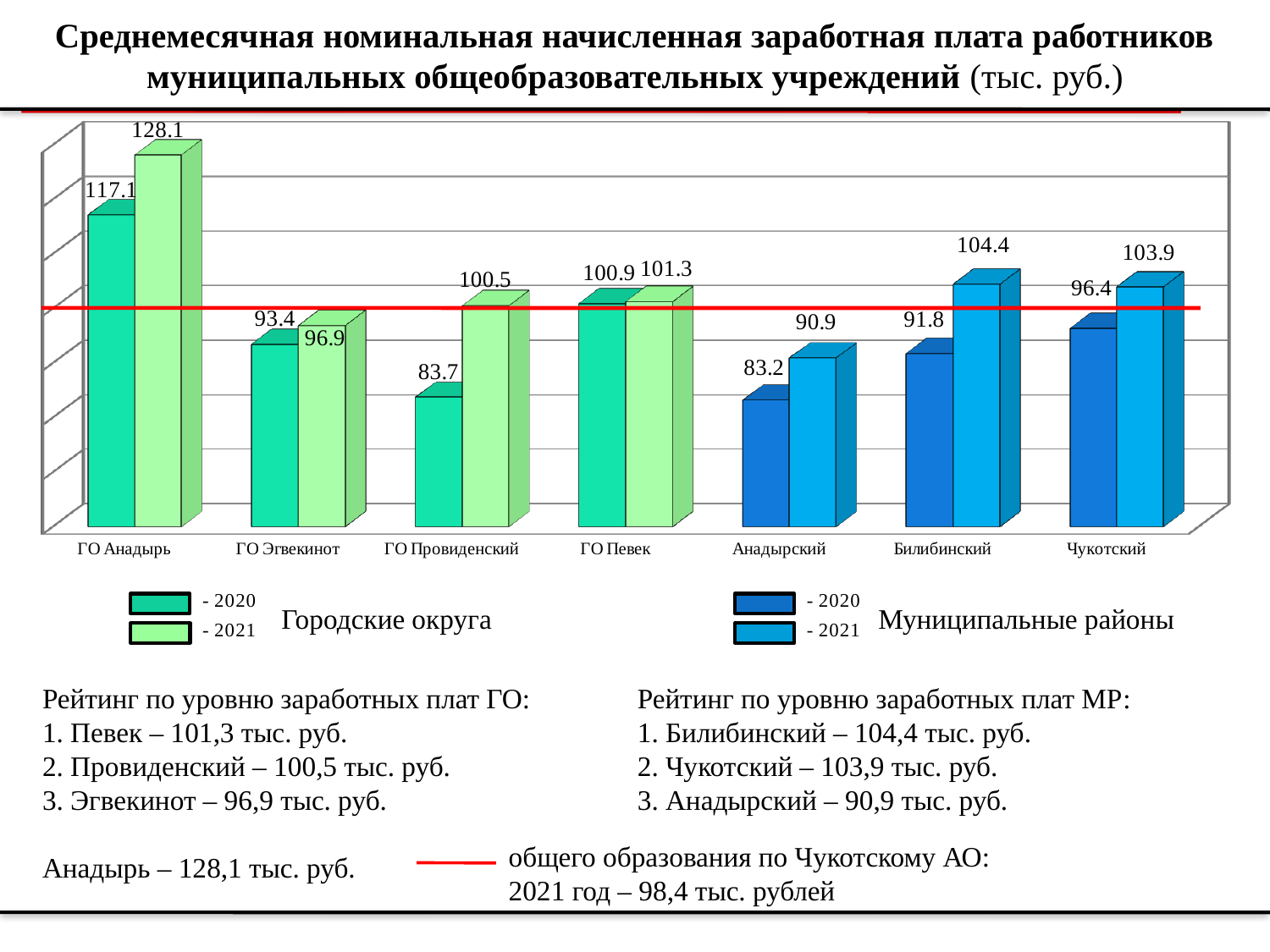
What was the 2020 value for Анадырский? 83.2 Which category has the highest 2021 value? ГО Анадырь Which category has the lowest 2020 value? Анадырский What is the difference between the 2021 values for Билибинский and Чукотский? 0.5 Which is larger: the 2021 value for ГО Эгвекинот or the 2021 value for Чукотский? Чукотский What was the 2020 value for Билибинский? 91.8 What is the difference between the 2021 and 2020 values for ГО Провиденский? 16.8 What kind of chart is shown on the slide? bar chart What was the 2021 value for ГО Провиденский? 100.5 How many categories are shown on the x axis of the chart? 7 What value does the red horizontal line on the chart represent, according to the slide? 98,4 тыс. рублей What was the 2021 value for ГО Анадырь? 128.1